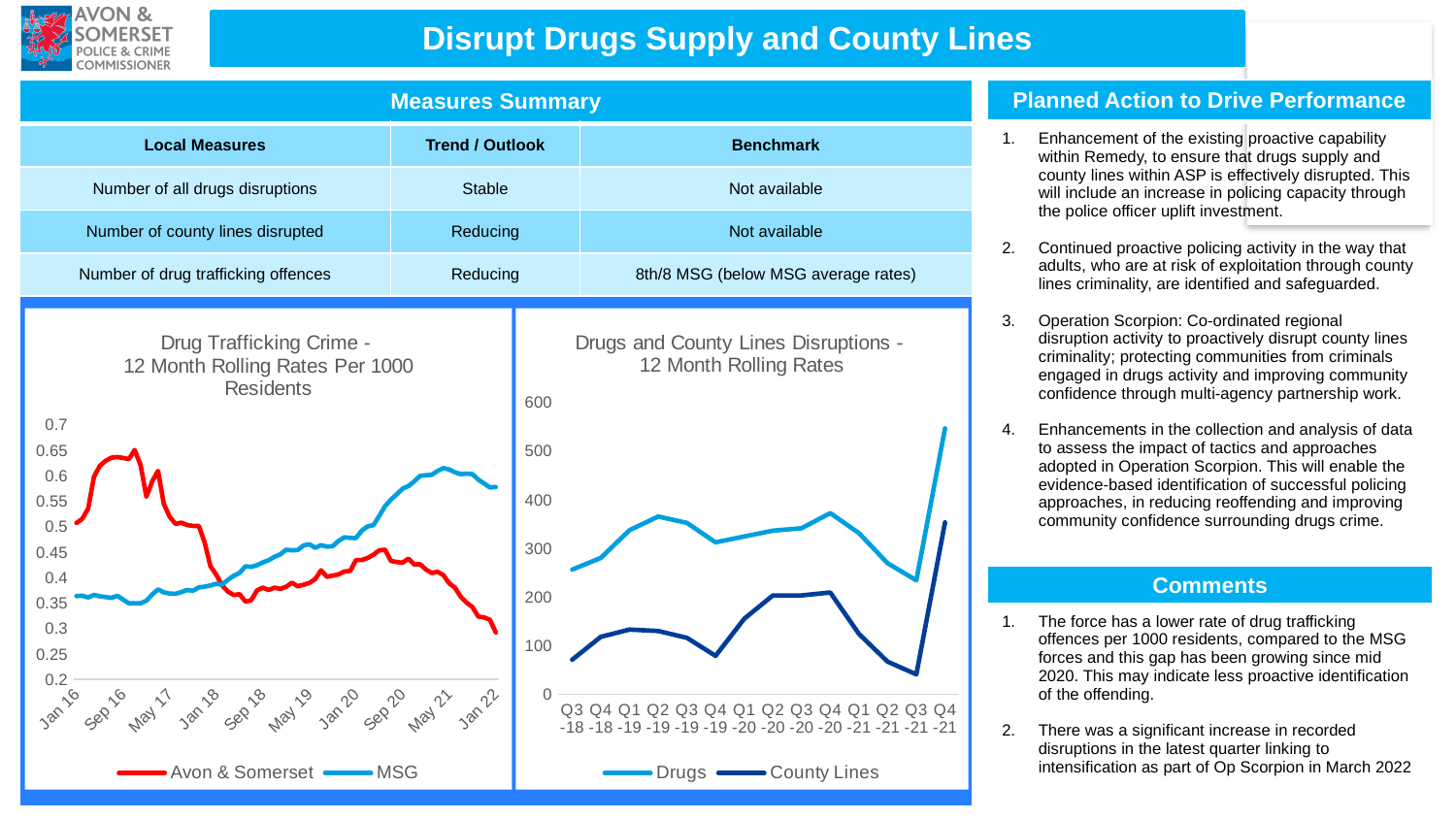
In the 'Drug Trafficking Crime' chart, what colour is the Avon & Somerset line? Red What kind of chart is the 'Drug Trafficking Crime - 12 Month Rolling Rates Per 1000 Residents' chart? Line chart In the 'Drugs and County Lines Disruptions' chart, is the value for Drugs at Q4-21 greater or less than 500? greater In the 'Drugs and County Lines Disruptions' chart, is the value for County Lines at Q3-21 greater or less than 100? less In the 'Drug Trafficking Crime' chart, is the value for MSG at Jan 22 greater or less than 0.5? greater How many series does the legend of the 'Drugs and County Lines Disruptions - 12 Month Rolling Rates' chart list? 2 In the 'Drugs and County Lines Disruptions' chart, which series is higher at Q4-21, Drugs or County Lines? Drugs In the 'Drugs and County Lines Disruptions' chart, how many quarters are shown on the x axis? 14 In the 'Drug Trafficking Crime' chart, which series is higher at Jan 22, Avon & Somerset or MSG? MSG In the 'Drug Trafficking Crime' chart, does the Avon & Somerset line overall rise or fall from Jan 16 to Jan 22? Fall